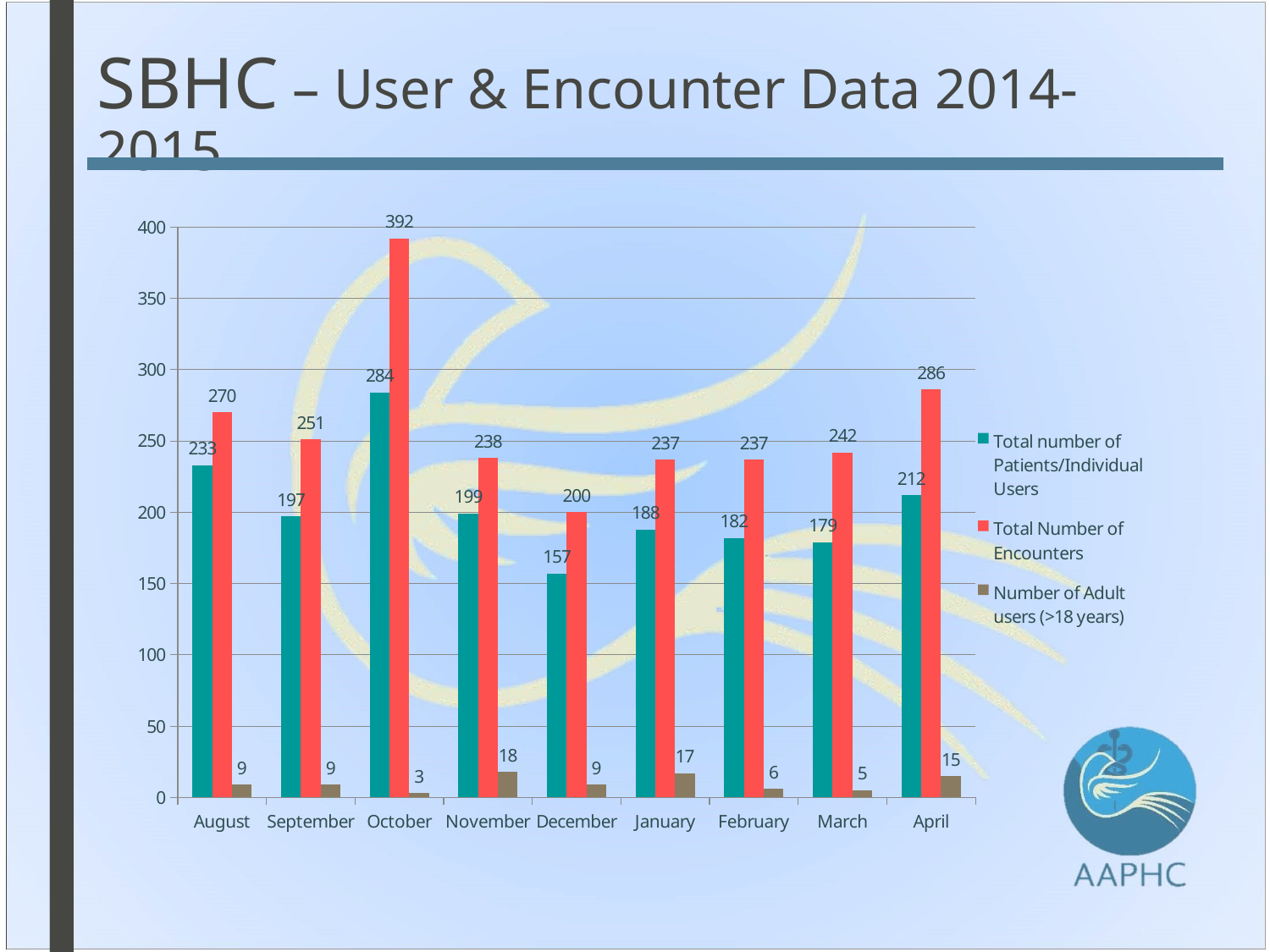
What is the Number of Adult users (>18 years) for November? 18 Is the Total Number of Encounters for April greater or less than 250? greater Which colour represents the Total Number of Encounters series? red What is the Total number of Patients/Individual Users for December? 157 What is the difference between the Total Number of Encounters and the Total number of Patients/Individual Users in October? 108 How many months are shown on the x axis? 9 Which month has the highest Total Number of Encounters? October What is the Total Number of Encounters for October? 392 What kind of chart is shown on the slide? bar chart Which month has the lowest Number of Adult users (>18 years)? October Which is larger: the Total number of Patients/Individual Users in August or in April? August How many series does the legend list? 3